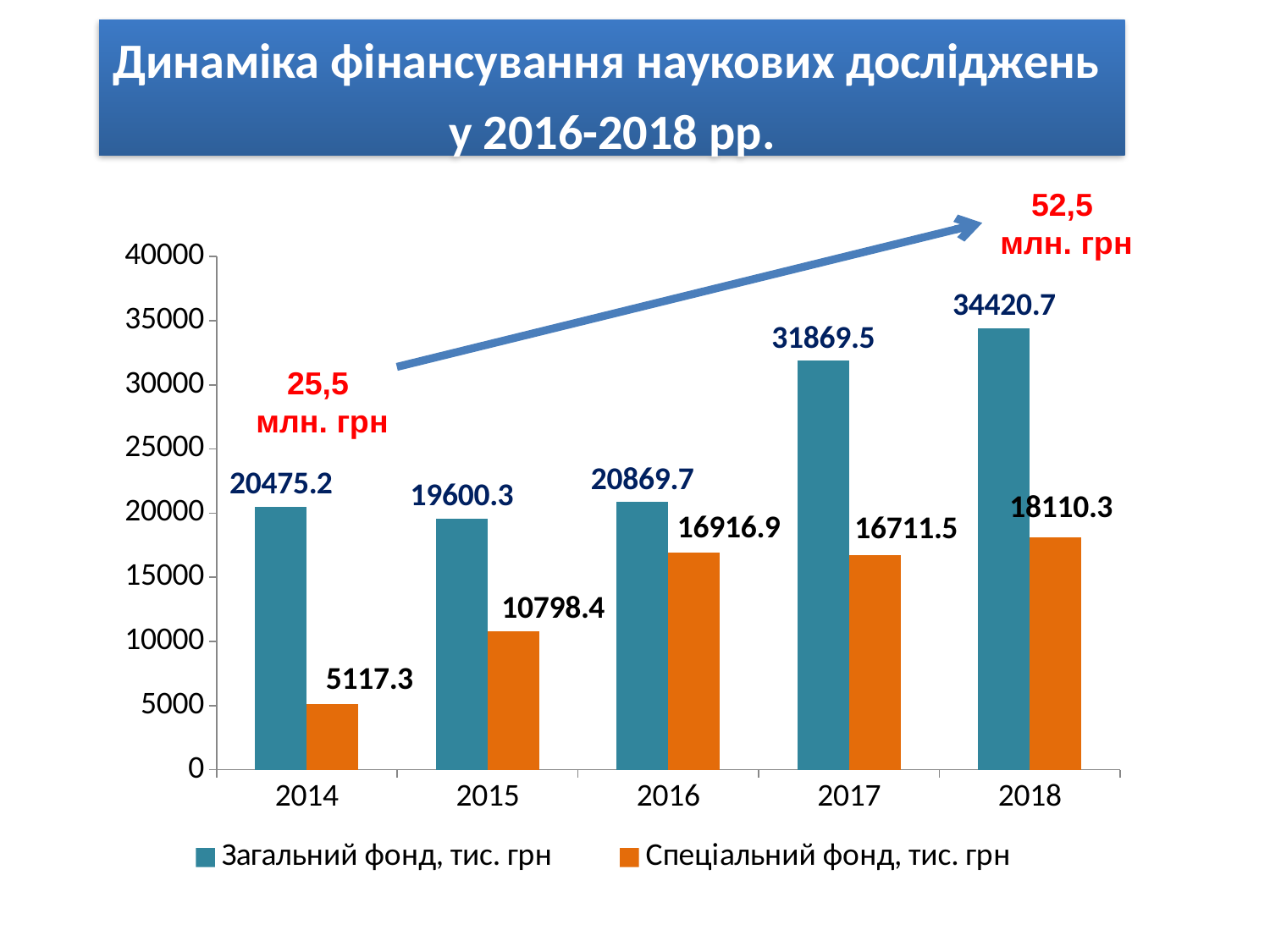
In which year is Загальний фонд, тис. грн the highest? 2018 Which colour represents Спеціальний фонд, тис. грн in the chart? orange What kind of chart is shown on the slide? bar chart In which year is Спеціальний фонд, тис. грн the lowest? 2014 How many years are shown on the x axis? 5 What is the value of Загальний фонд, тис. грн for 2017? 31869.5 What is the value of Спеціальний фонд, тис. грн for 2018? 18110.3 How many series does the legend list? 2 Which is larger: Спеціальний фонд, тис. грн in 2016 or in 2017? 2016 What is the value of Спеціальний фонд, тис. грн for 2014? 5117.3 What is the difference between Загальний фонд, тис. грн in 2018 and in 2017? 2551.2 Is the value of Загальний фонд, тис. грн for 2015 greater or less than 20000? less